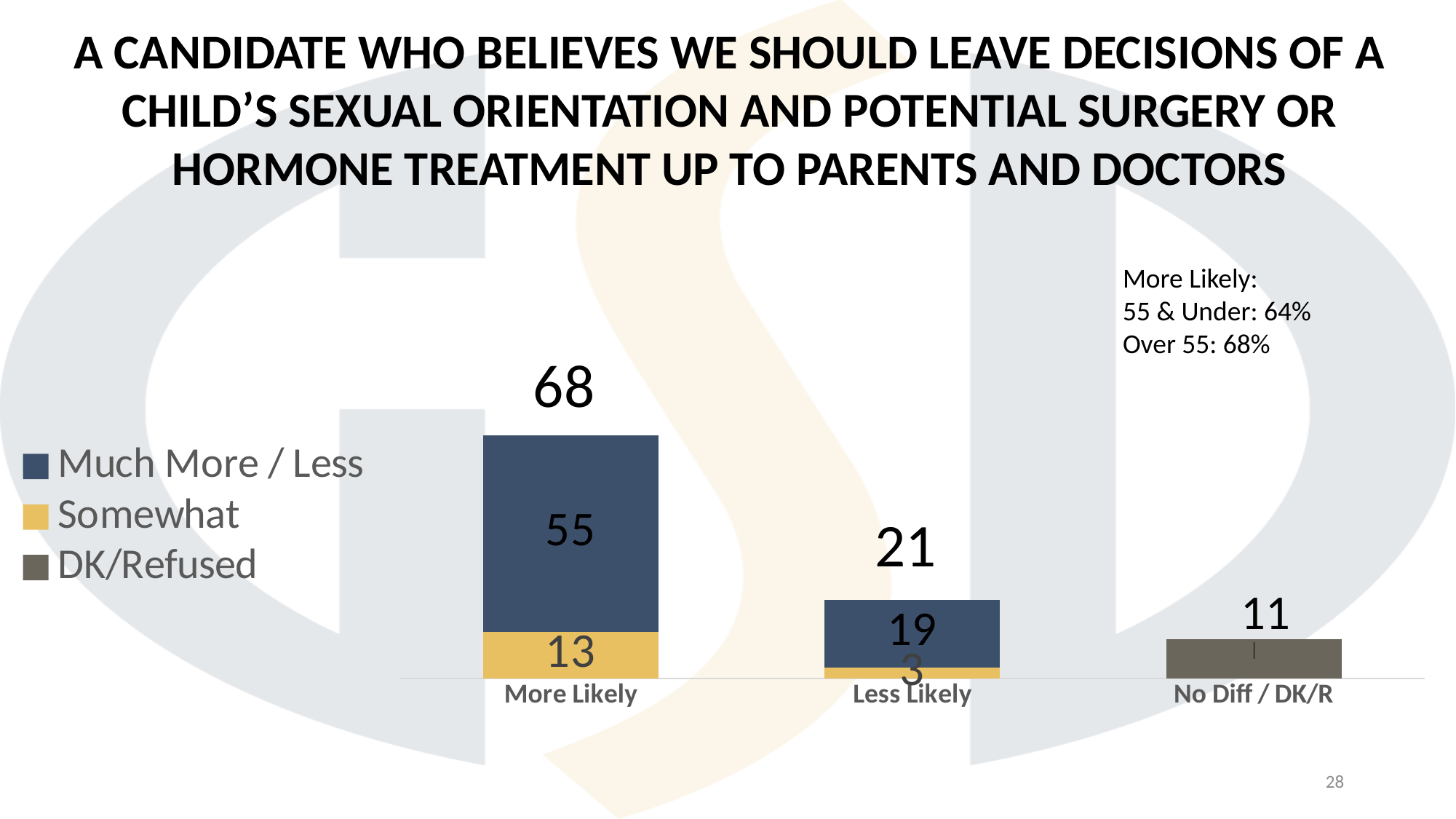
What is the total of the 'More Likely' stacked bar? 68 What is the 'Much More / Less' value for the 'Less Likely' bar? 19 What is the 'Somewhat' value for the 'Less Likely' bar? 3 Which category has the highest total value? More Likely What is the difference between the 'More Likely' total and the 'Less Likely' total? 47 What is the value for 'No Diff / DK/R'? 11 How many categories are shown on the x axis of the chart? 3 What is the total of the 'Less Likely' stacked bar? 21 How many series does the chart's legend list? 3 What kind of chart is shown on the slide? stacked bar chart What is the 'Much More / Less' value for the 'More Likely' bar? 55 What is the 'Somewhat' value for the 'More Likely' bar? 13